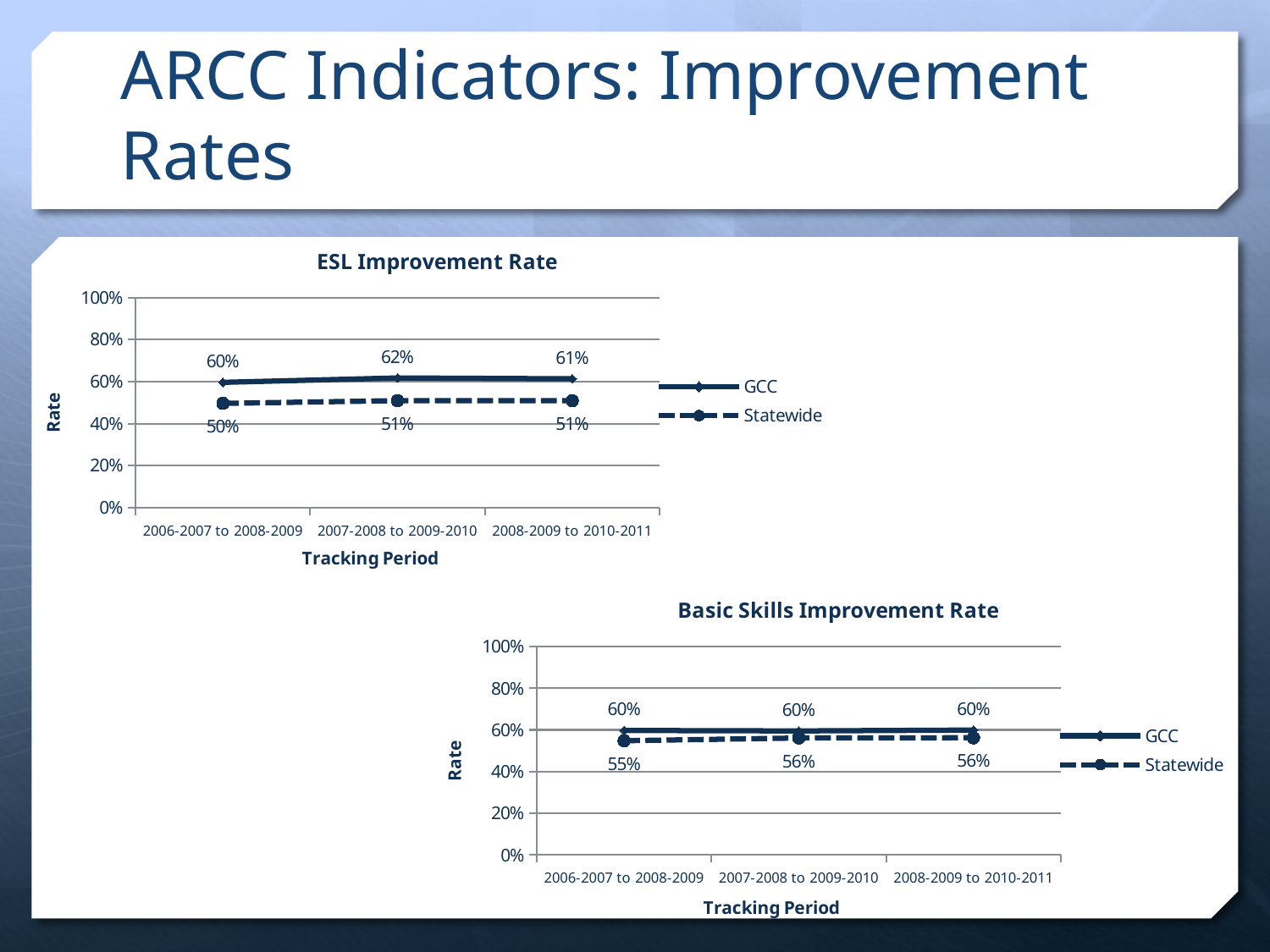
In the Basic Skills Improvement Rate chart, is the GCC value for 2006-2007 to 2008-2009 greater or less than 80%? less In the ESL Improvement Rate chart, which series is higher for 2006-2007 to 2008-2009, GCC or Statewide? GCC What kind of chart is the Basic Skills Improvement Rate chart? Line chart In the ESL Improvement Rate chart, what is the difference between the GCC and Statewide values for 2008-2009 to 2010-2011? 10% In the Basic Skills Improvement Rate chart, what is the Statewide value for 2006-2007 to 2008-2009? 55% In the ESL Improvement Rate chart, how many series does the legend list? 2 In the Basic Skills Improvement Rate chart, what is the difference between the GCC and Statewide values for 2007-2008 to 2009-2010? 4% In the ESL Improvement Rate chart, which tracking period has the highest GCC value? 2007-2008 to 2009-2010 In the ESL Improvement Rate chart, what is the Statewide value for 2006-2007 to 2008-2009? 50% In the Basic Skills Improvement Rate chart, what is the GCC value for 2008-2009 to 2010-2011? 60% In the Basic Skills Improvement Rate chart, how many tracking periods are shown on the x axis? 3 In the ESL Improvement Rate chart, what is the GCC value for 2007-2008 to 2009-2010? 62%